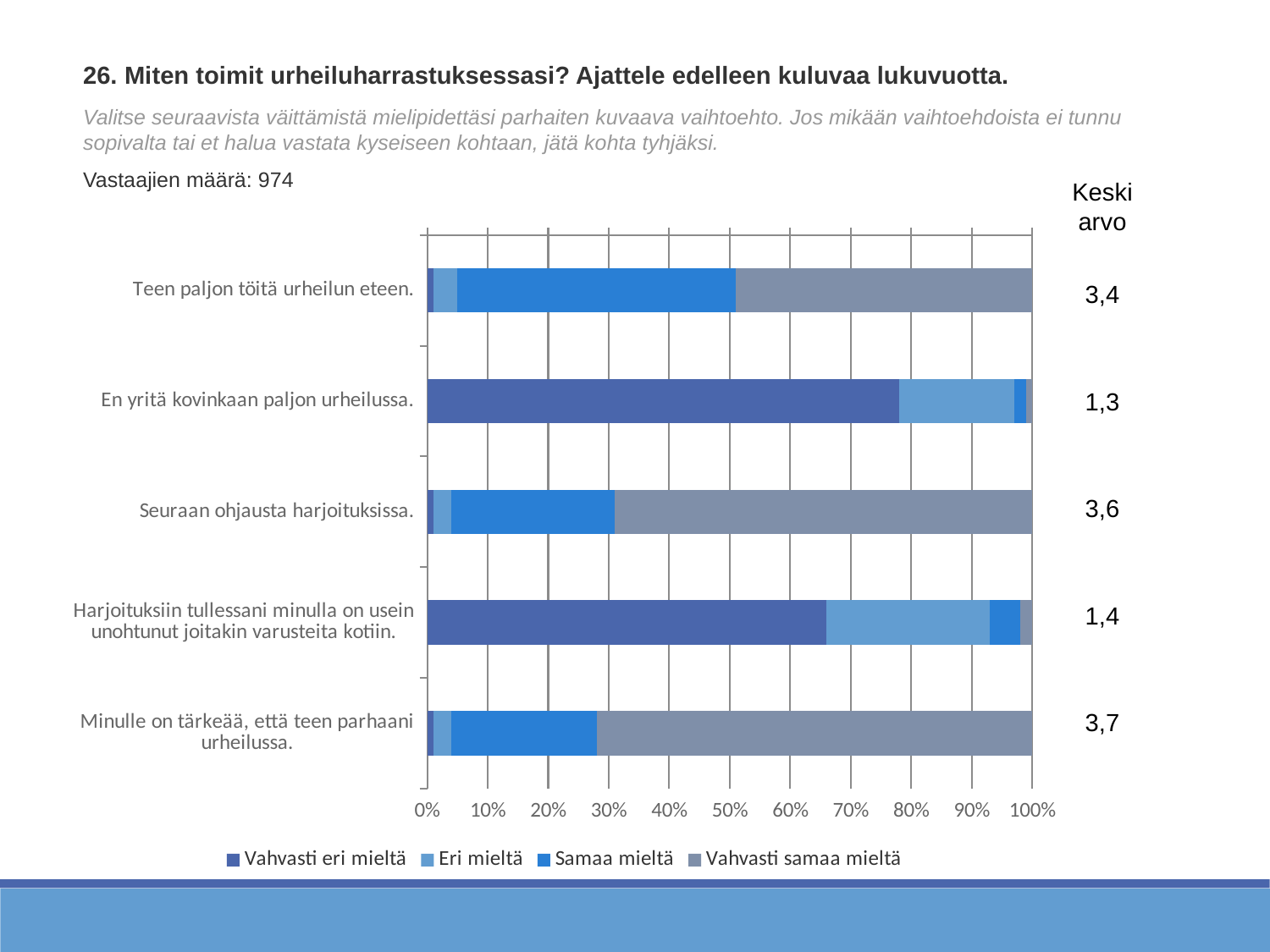
Is the "Vahvasti eri mieltä" share for "En yritä kovinkaan paljon urheilussa." greater or less than 70%? greater Is the "Vahvasti samaa mieltä" share for "Seuraan ohjausta harjoituksissa." greater or less than 60%? greater How many series does the chart legend list? 4 Which statement has the lowest Keskiarvo (mean) value? En yritä kovinkaan paljon urheilussa. What is the Keskiarvo (mean) value shown for "Teen paljon töitä urheilun eteen."? 3,4 What is the Keskiarvo (mean) value shown for "En yritä kovinkaan paljon urheilussa."? 1,3 What is the difference between the highest Keskiarvo value (3,7) and the lowest (1,3)? 2,4 What kind of chart is shown on the slide? bar chart How many statements (categories) are plotted in the chart? 5 Which has a higher Keskiarvo value: "Seuraan ohjausta harjoituksissa." or "Teen paljon töitä urheilun eteen."? Seuraan ohjausta harjoituksissa. Which statement has the highest Keskiarvo (mean) value? Minulle on tärkeää, että teen parhaani urheilussa. What is the Keskiarvo (mean) value shown for "Harjoituksiin tullessani minulla on usein unohtunut joitakin varusteita kotiin."? 1,4